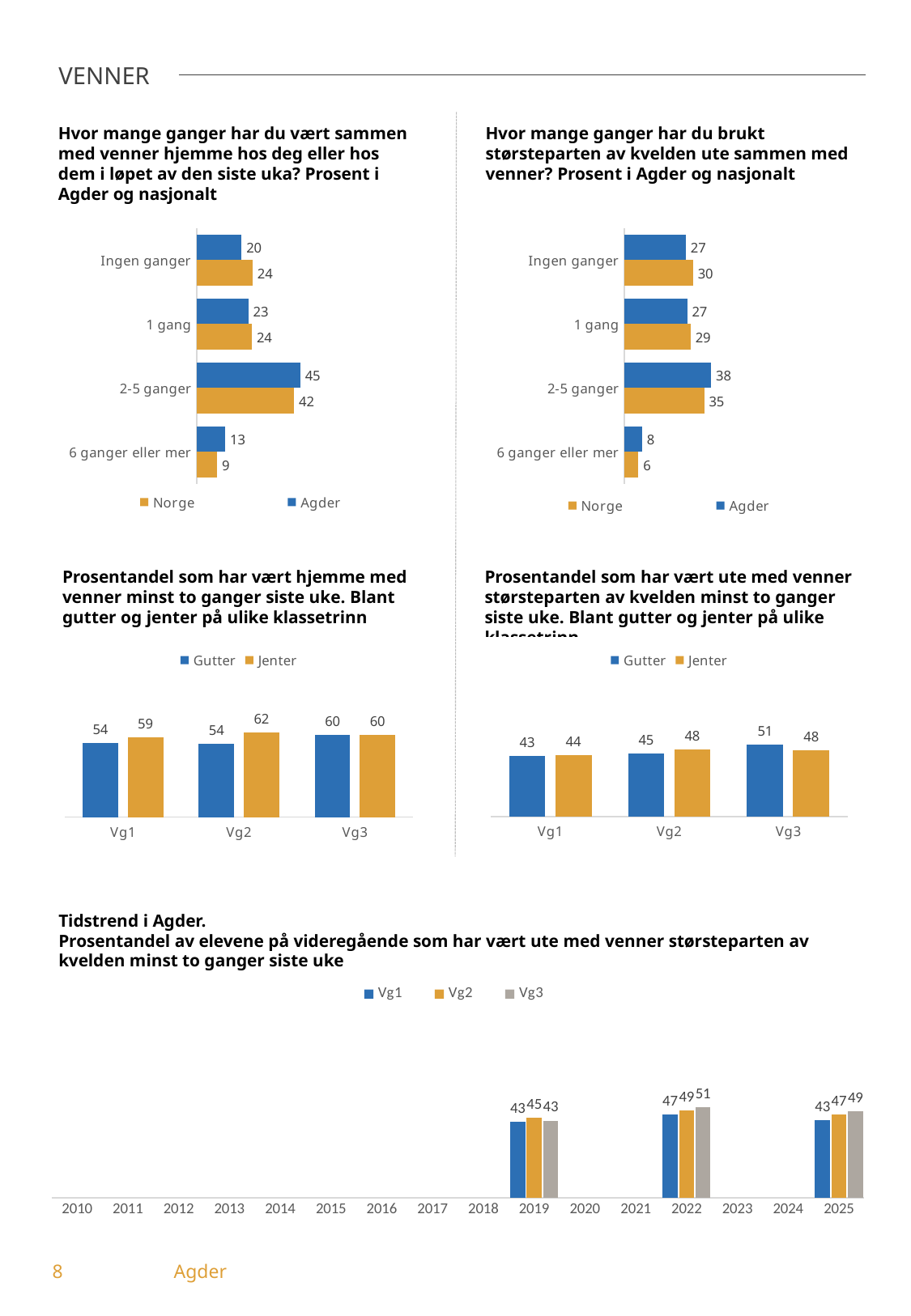
In the middle-left chart (hjemme med venner minst to ganger siste uke), what is the value for Jenter at Vg2? 62 In the middle-right chart (ute med venner størsteparten av kvelden minst to ganger), what kind of chart is it? Bar chart In the middle-left chart (hjemme med venner minst to ganger siste uke), how many series does the legend list? 2 In the top-left chart (venner hjemme hos deg eller hos dem), what is the value for Agder in the '2-5 ganger' category? 45 In the middle-right chart (ute med venner størsteparten av kvelden minst to ganger), what is the difference between Gutter and Jenter at Vg3? 3 In the bottom chart (Tidstrend i Agder), what is the value for Vg3 in 2022? 51 In the top-left chart (venner hjemme hos deg eller hos dem), which category has the lowest value for Norge? 6 ganger eller mer In the bottom chart (Tidstrend i Agder), how many series does the legend list? 3 In the top-right chart (størsteparten av kvelden ute sammen med venner), what is the value for Norge in the 'Ingen ganger' category? 30 In the top-right chart (størsteparten av kvelden ute sammen med venner), is the value for Agder or Norge larger in the '6 ganger eller mer' category? Agder In the top-left chart (venner hjemme hos deg eller hos dem), what is the difference between Norge and Agder for 'Ingen ganger'? 4 In the top-right chart (størsteparten av kvelden ute sammen med venner), which category has the highest value for Agder? 2-5 ganger